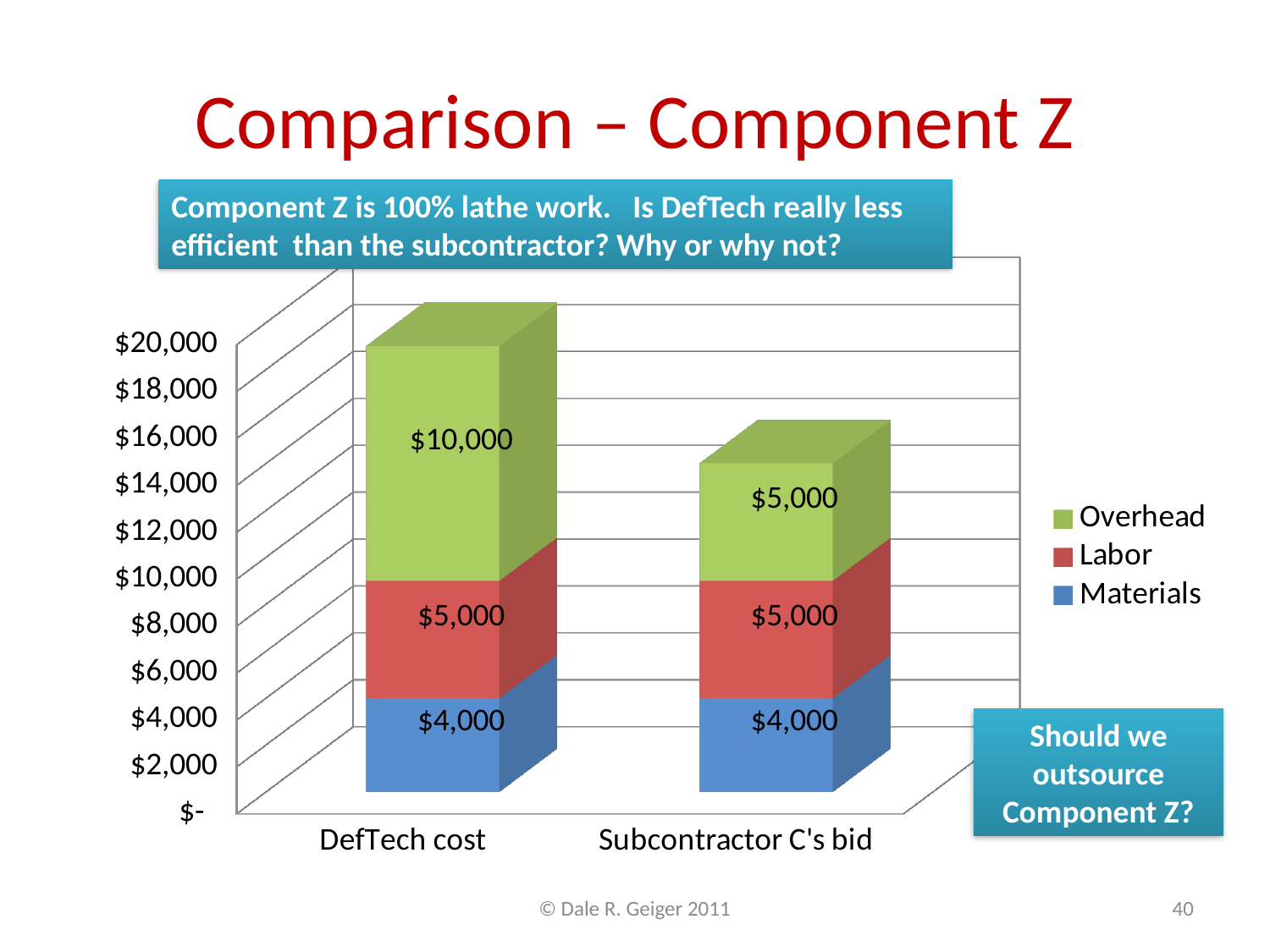
What is the Labor value for DefTech cost? $5,000 How many categories are shown on the x axis? 2 What is the Materials value for Subcontractor C's bid? $4,000 What is the Overhead value for DefTech cost? $10,000 What is the total of the stacked bar for Subcontractor C's bid? $14,000 Which series is shown in green in the legend? Overhead What kind of chart is shown on the slide? Stacked bar chart How many series does the legend list? 3 Which category has the higher Overhead value, DefTech cost or Subcontractor C's bid? DefTech cost What is the difference between the Overhead values for DefTech cost and Subcontractor C's bid? $5,000 What is the total of the stacked bar for DefTech cost? $19,000 What is the Overhead value for Subcontractor C's bid? $5,000